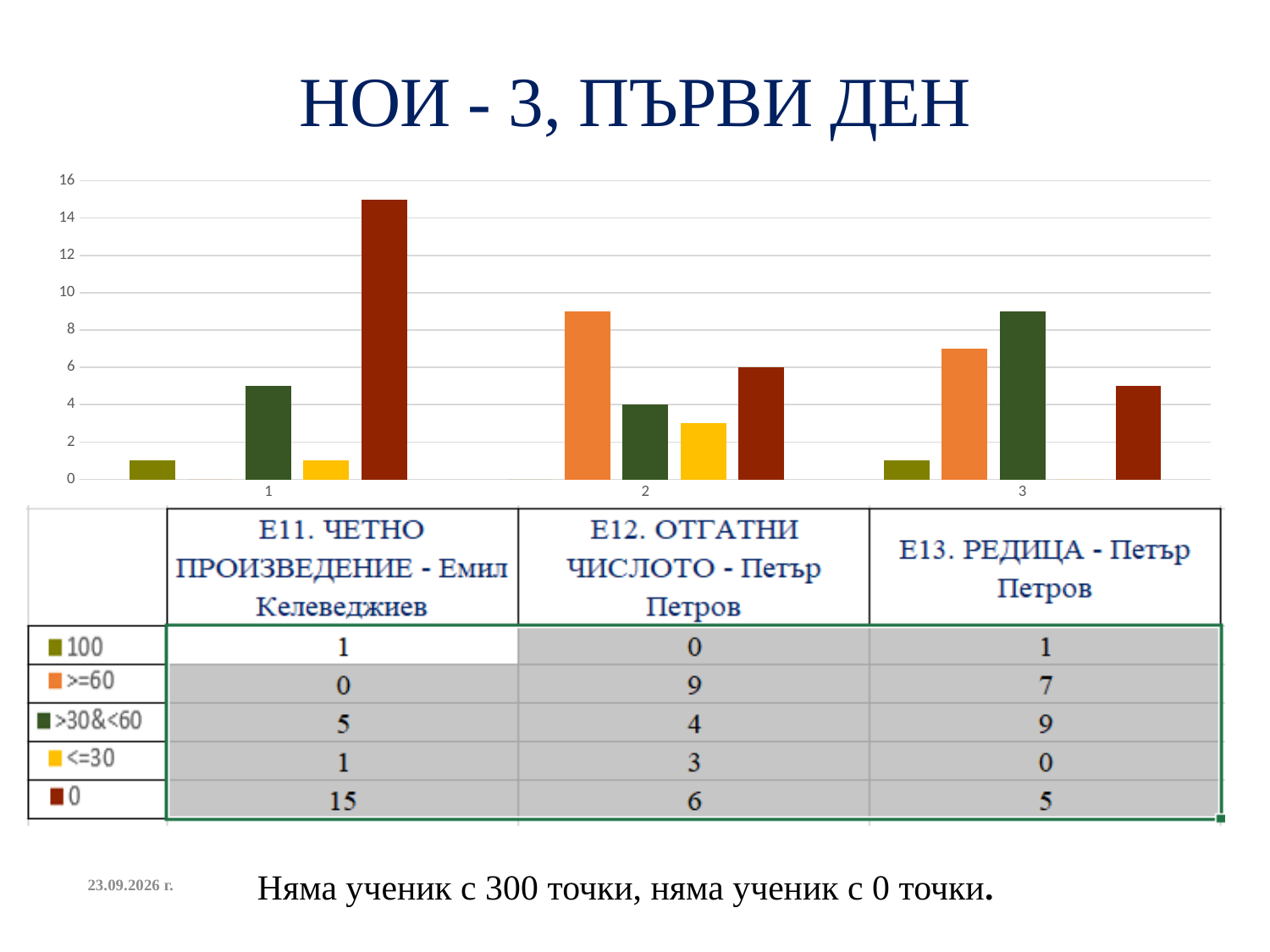
What is the title of the slide containing the chart? НОИ - 3, ПЪРВИ ДЕН Which is larger: the ">=60" value for group 2 or the ">=60" value for group 3? group 2 Which series has the lowest value in group 3 (E13. РЕДИЦА)? <=30 What kind of chart is shown on the slide? bar chart How many series does the legend list? 5 What is the difference between the "0" series value for group 1 and the "0" series value for group 2? 9 What is the value of the ">30&<60" series for group 3 (E13. РЕДИЦА)? 9 What is the value of the ">=60" series for group 2 (E12. ОТГАТНИ ЧИСЛОТО)? 9 What is the value of the "<=30" series for group 2 (E12. ОТГАТНИ ЧИСЛОТО)? 3 Which series has the highest value in group 1 (E11. ЧЕТНО ПРОИЗВЕДЕНИЕ)? 0 What is the value of the "0" series for group 1 (E11. ЧЕТНО ПРОИЗВЕДЕНИЕ)? 15 How many category groups are plotted along the x axis? 3